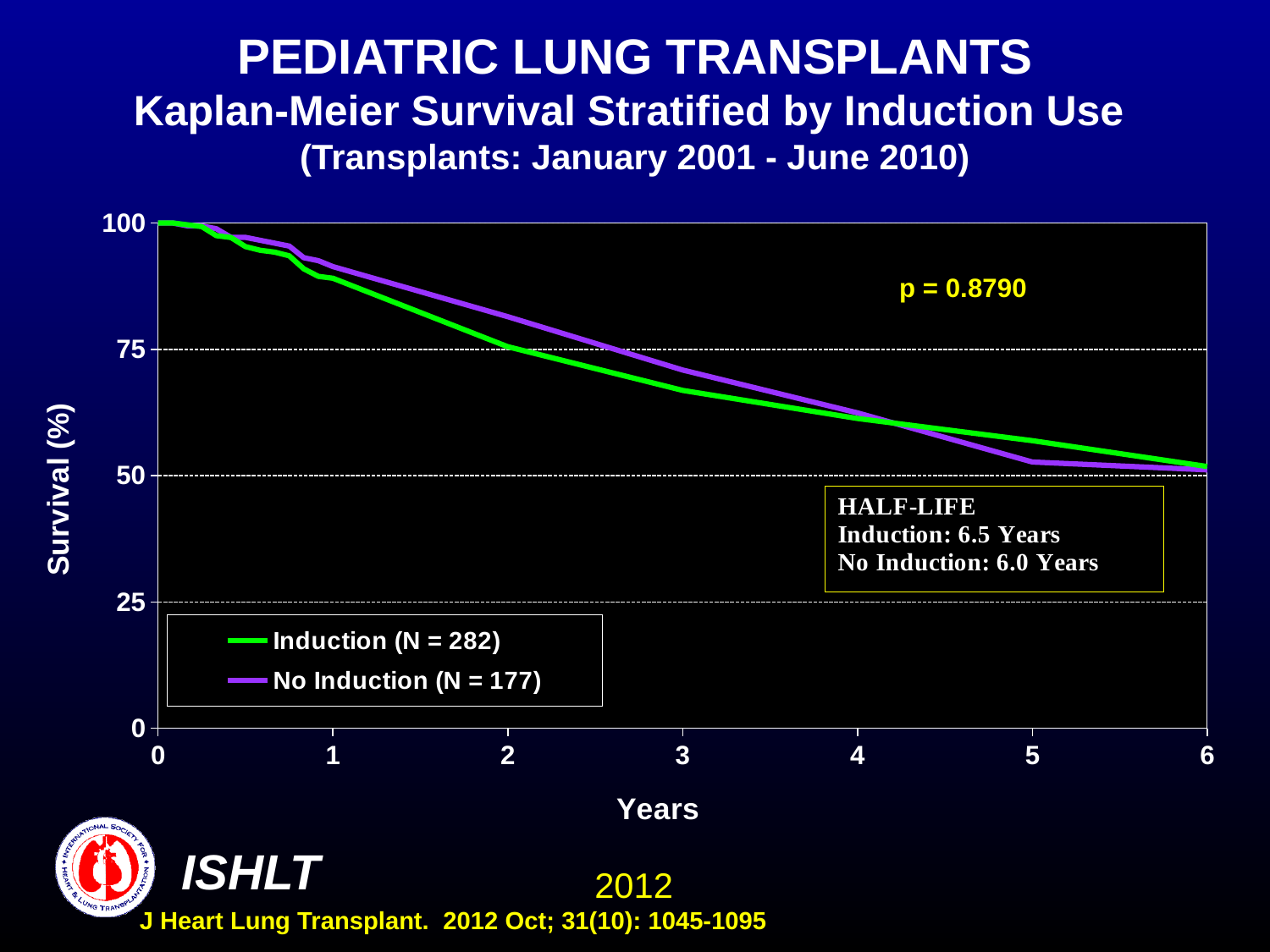
Do the survival curves rise or fall as years increase? Fall What p-value is printed on the chart? p = 0.8790 What is the N for the Induction group shown in the legend? 282 Is the survival for the No Induction group at 4 years greater or less than 75? less What is the difference in half-life between the Induction and No Induction groups? 0.5 Years What kind of chart is shown on the slide? Line chart What is the half-life for the No Induction group? 6.0 Years What is the N for the No Induction group shown in the legend? 177 How many series does the legend list? 2 Is the survival for the Induction group at 1 year greater or less than 75? greater At 2 years, which group has the higher survival, Induction or No Induction? No Induction What is the half-life for the Induction group? 6.5 Years